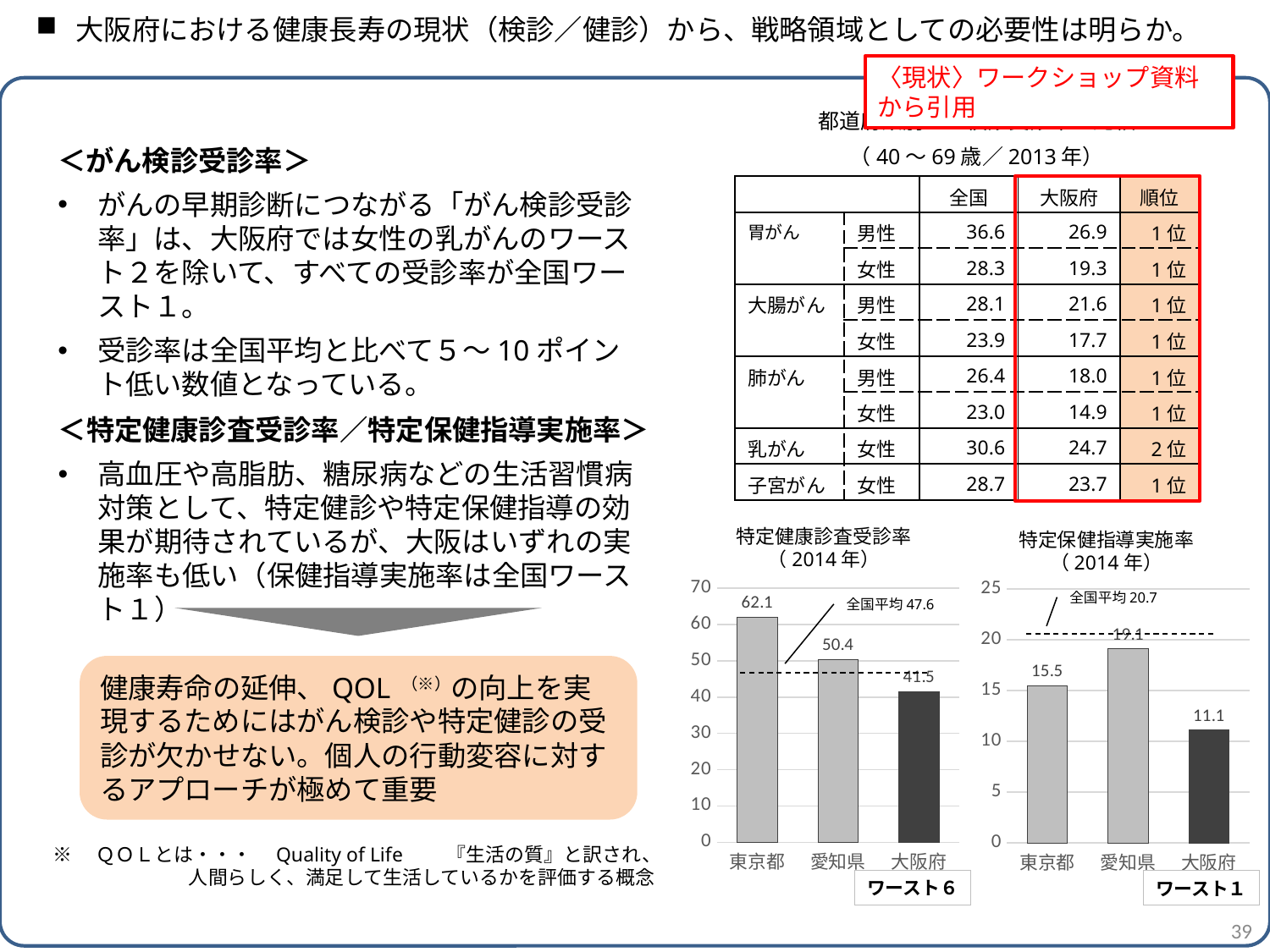
In the 特定健康診査受診率（2014年） chart, which prefecture has the lowest value? 大阪府 In the 特定健康診査受診率（2014年） chart, what is the value for 大阪府? 41.5 In the 特定保健指導実施率（2014年） chart, which prefecture has the highest value? 愛知県 In the 特定健康診査受診率（2014年） chart, what is the difference between 東京都 and 大阪府? 20.6 In the 特定健康診査受診率（2014年） chart, how many prefectures are plotted? 3 In the 特定保健指導実施率（2014年） chart, which is larger, the value for 東京都 or 大阪府? 東京都 In the 特定健康診査受診率（2014年） chart, what is the value for 東京都? 62.1 What kind of chart is the 特定保健指導実施率（2014年） chart? bar chart In the 特定保健指導実施率（2014年） chart, what is the difference between 愛知県 and 大阪府? 8.0 In the 特定保健指導実施率（2014年） chart, what is the value for 大阪府? 11.1 In the 特定健康診査受診率（2014年） chart, what national average (全国平均) is shown by the dashed line? 47.6 In the 特定保健指導実施率（2014年） chart, what is the value for 愛知県? 19.1